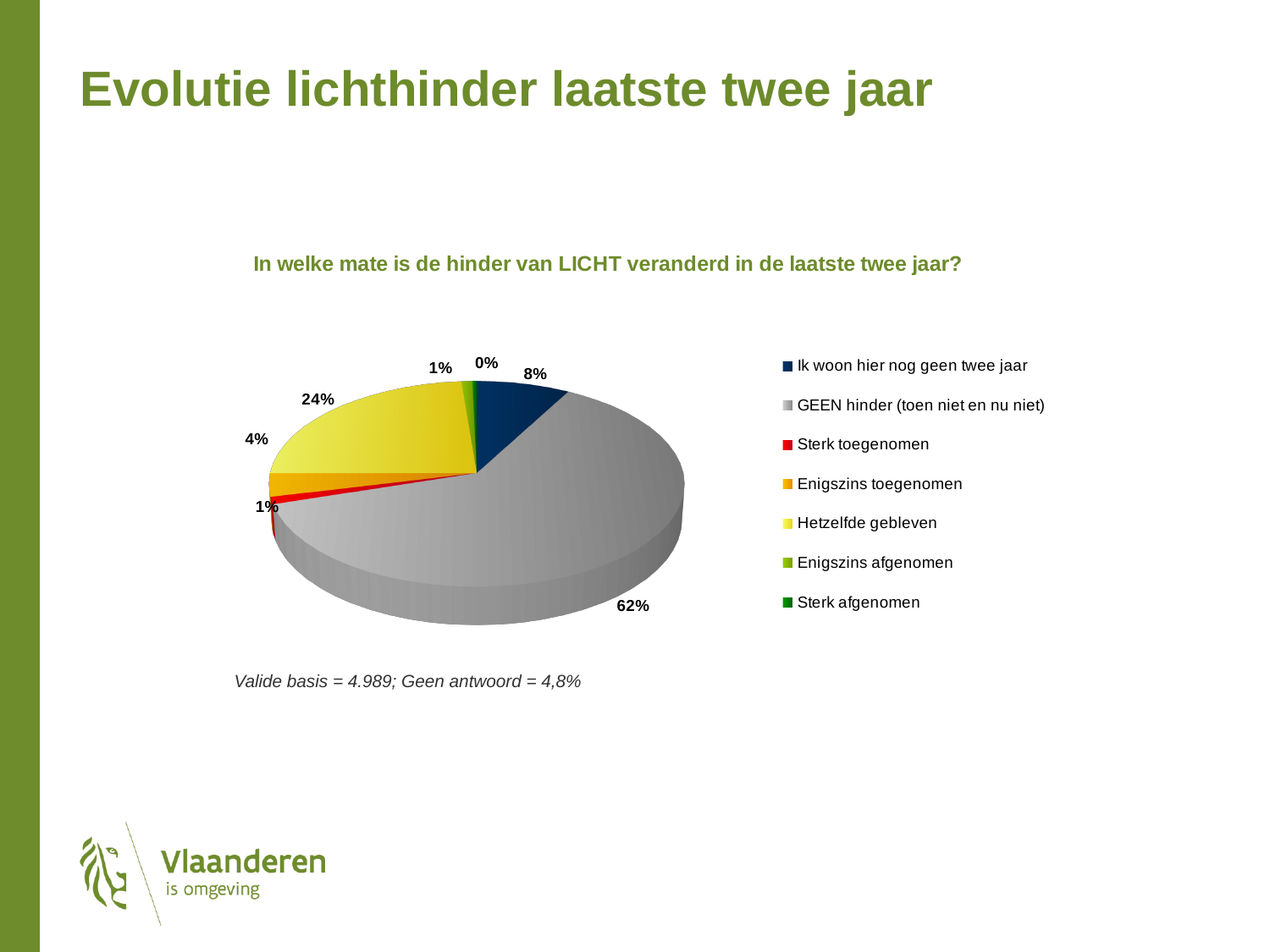
Which is larger: the share for 'Ik woon hier nog geen twee jaar' or the share for 'Enigszins toegenomen'? Ik woon hier nog geen twee jaar What type of chart is shown on the slide? pie chart What share of the pie is 'Enigszins toegenomen'? 4% Which category has the smallest slice of the pie? Sterk afgenomen What is the question shown as the title above the pie chart? In welke mate is de hinder van LICHT veranderd in de laatste twee jaar? Which category has the largest slice of the pie? GEEN hinder (toen niet en nu niet) What is the difference between the shares for 'GEEN hinder (toen niet en nu niet)' and 'Hetzelfde gebleven'? 38% What share of the pie is 'GEEN hinder (toen niet en nu niet)'? 62% What share of the pie is 'Hetzelfde gebleven'? 24% How many categories does the legend of the pie chart list? 7 What share of the pie is 'Sterk afgenomen'? 0% What share of the pie is 'Ik woon hier nog geen twee jaar'? 8%